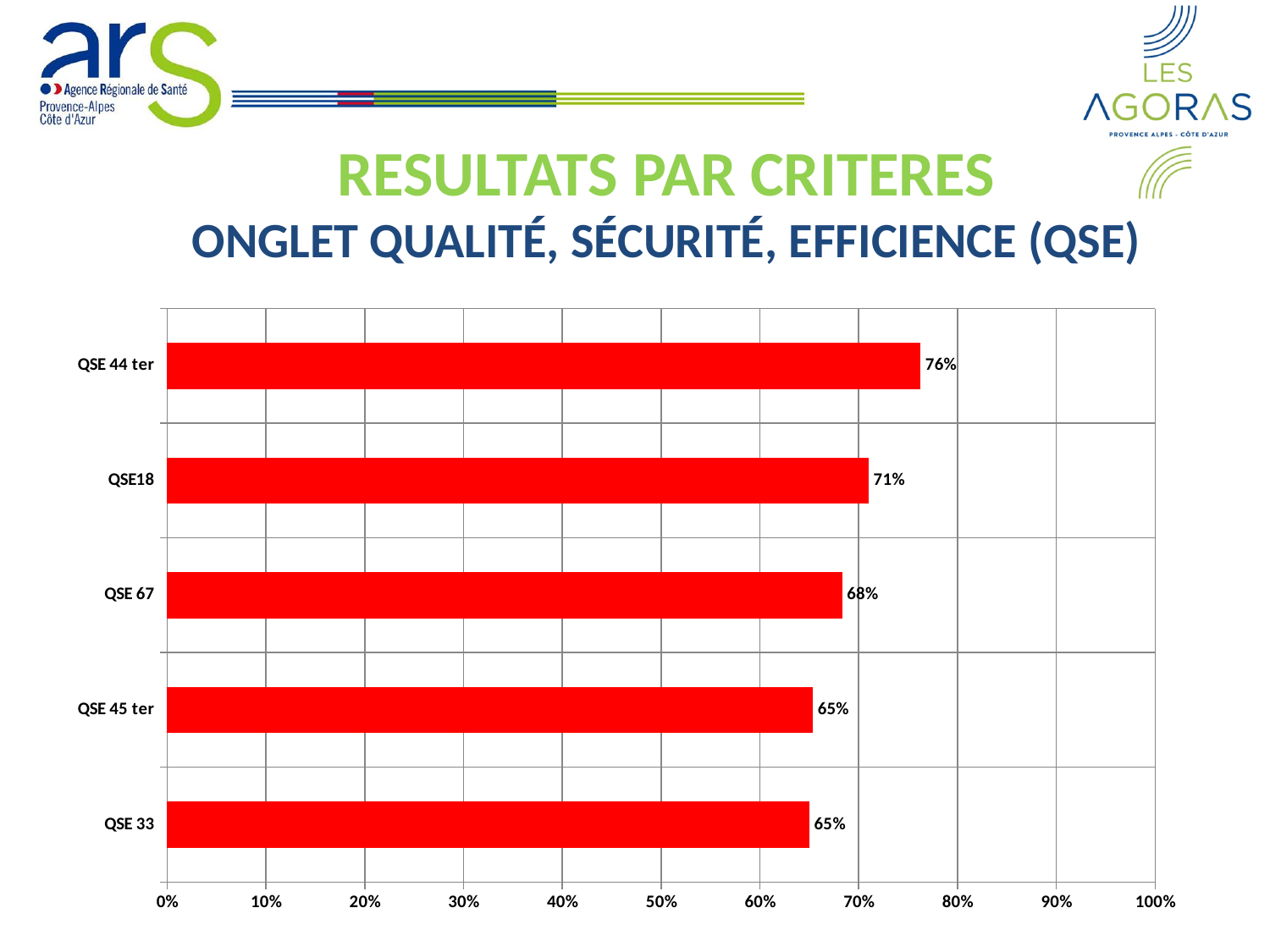
What colour are the bars in the chart? red How many categories are shown in the chart? 5 What is the value for QSE 44 ter? 76% Which category has the highest value? QSE 44 ter Which is larger, the value for QSE18 or the value for QSE 67? QSE18 What is the value for QSE 33? 65% What kind of chart is shown on the slide? bar chart What is the difference between the values for QSE 67 and QSE 45 ter? 3% What is the value for QSE18? 71% What is the value for QSE 67? 68% What is the difference between the values for QSE 44 ter and QSE18? 5% Is the value for QSE 45 ter greater or less than 70%? less